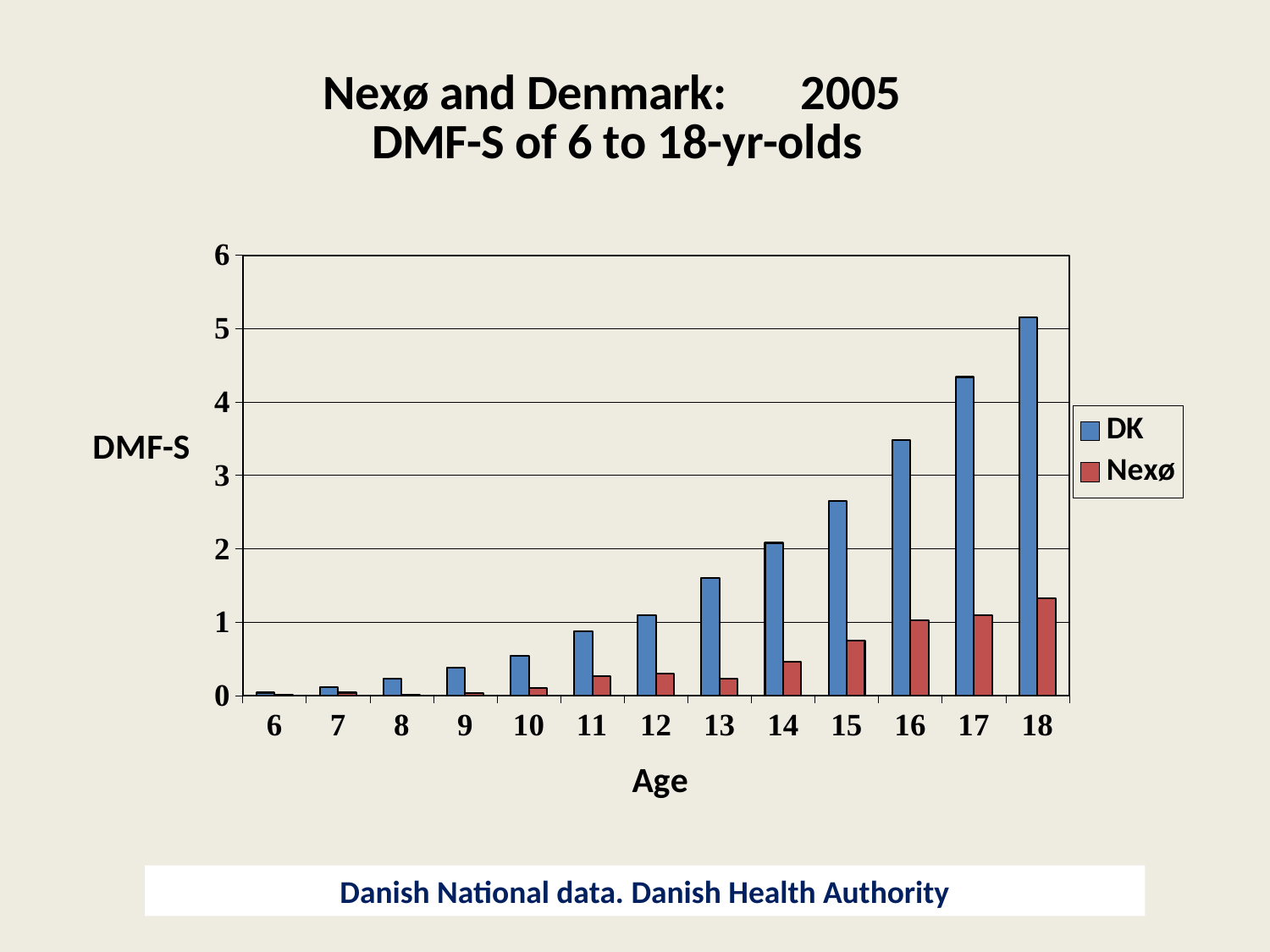
At which age is the DK value highest? 18 At age 18, which series has the larger value, DK or Nexø? DK What is the label on the y axis? DMF-S At which age is the DK value lowest? 6 Do the DK values rise or fall as age increases from 6 to 18? rise Is the DK value for age 17 greater or less than 4? greater At which age is the Nexø value highest? 18 Is the DK value for age 15 greater or less than 3? less How many series does the legend list? 2 How many age groups are plotted on the x axis? 13 Is the Nexø value for age 18 greater or less than 1? greater What kind of chart is shown on the slide? bar chart